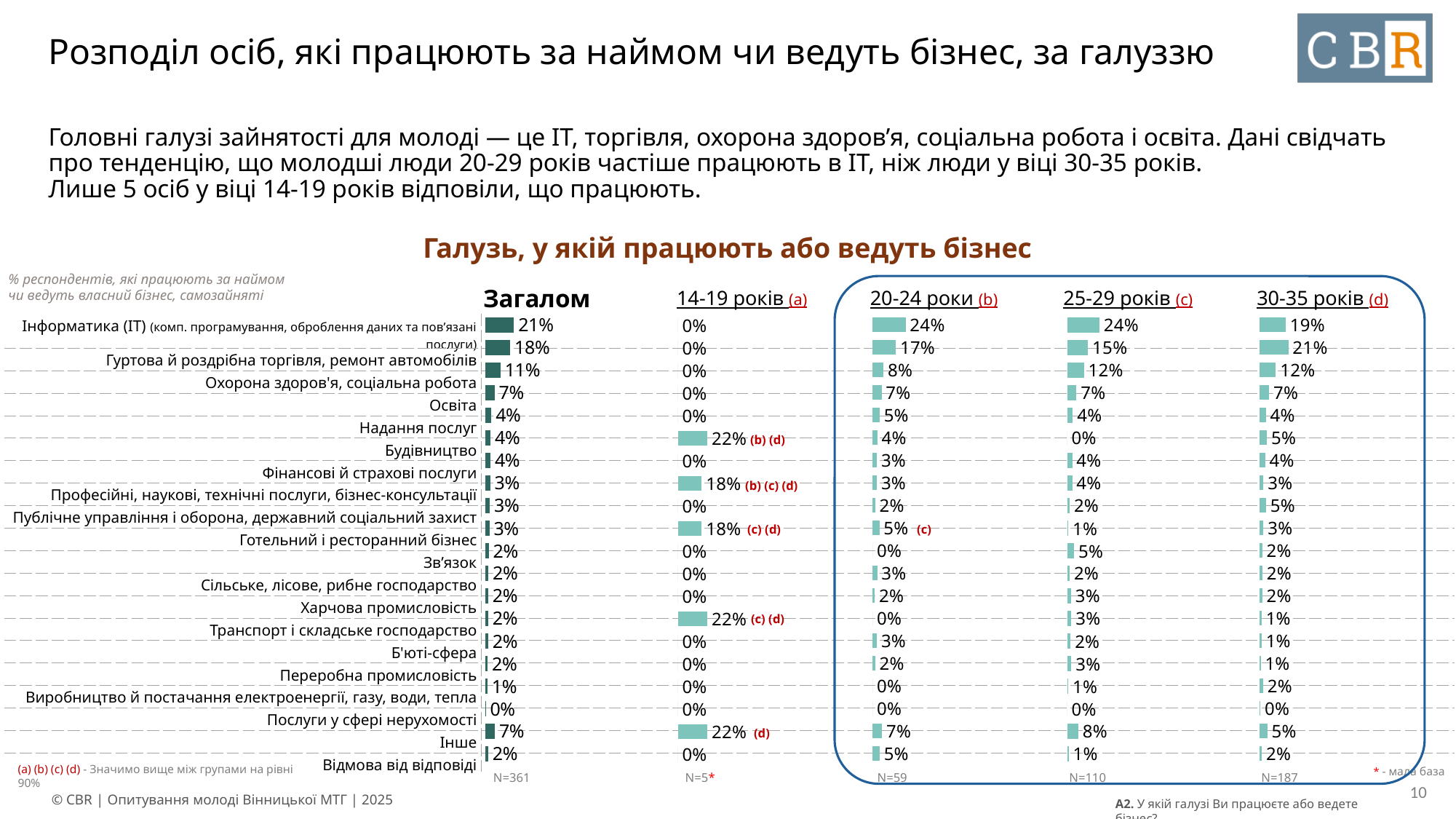
What is the sample size (N) shown for the Загалом column? N=361 What kind of chart is used on this slide? Bar chart Which industry has the highest value in the Загалом column? Інформатика (ІТ) What is the value for Охорона здоров'я, соціальна робота in the 25-29 років column? 12% What is the value for Гуртова й роздрібна торгівля, ремонт автомобілів in the 30-35 років column? 21% What is the value for Інформатика (ІТ) in the Загалом column? 21% What is the value for Будівництво in the 14-19 років column? 22% Which industry has the highest value in the 30-35 років column? Гуртова й роздрібна торгівля, ремонт автомобілів What is the difference between the Загалом values for Інформатика (ІТ) and Гуртова й роздрібна торгівля, ремонт автомобілів? 3% How many age-group columns (besides Загалом) does the chart show? 4 How many industry categories are listed in the chart? 20 Which is larger for Інформатика (ІТ): the 20-24 роки value or the 30-35 років value? 20-24 роки